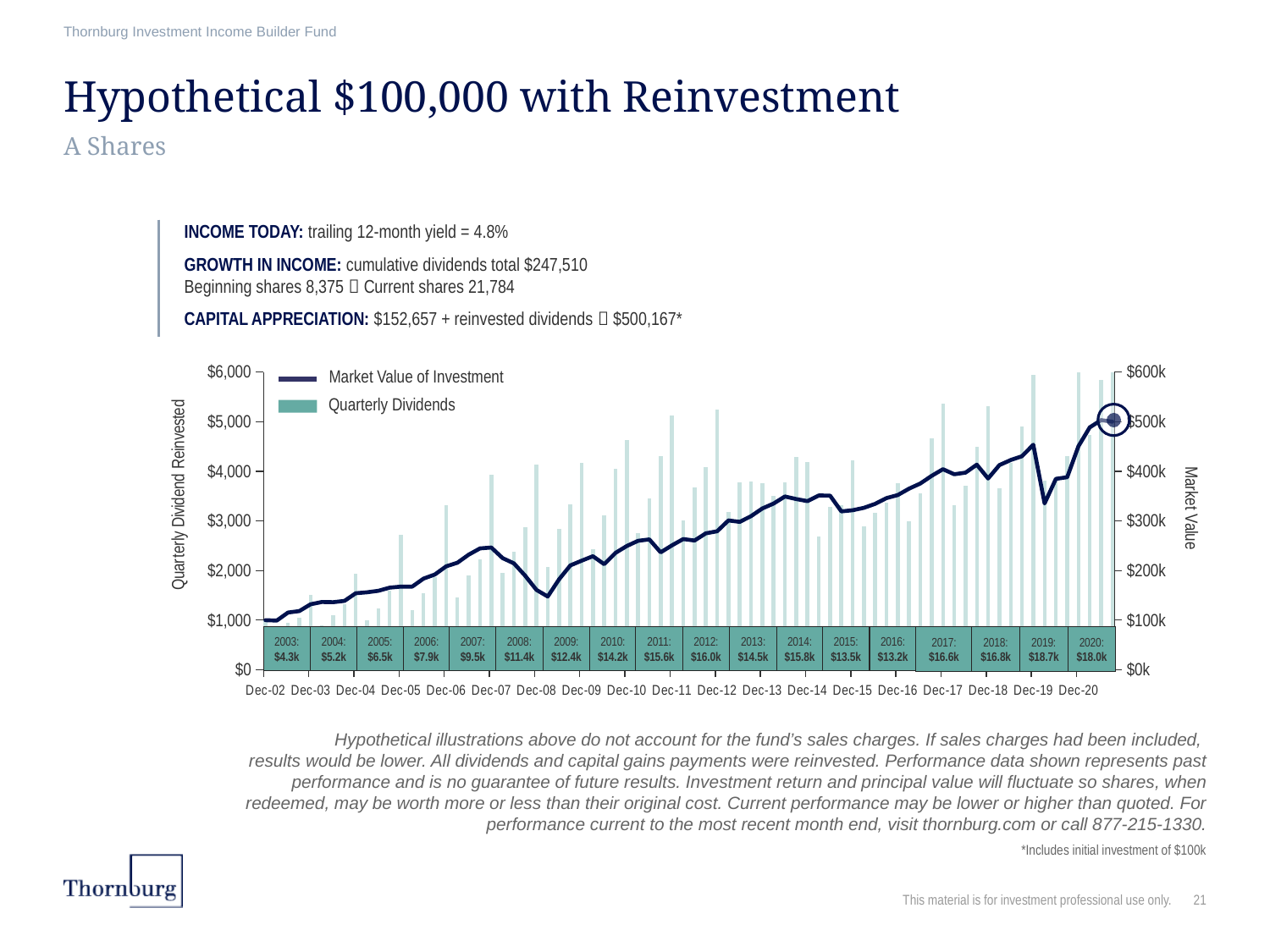
What is the annual dividend total shown for 2019? $18.7k What kind of chart is shown on the slide? Combined bar and line chart How many years have annual dividend totals printed in the band along the bottom of the chart? 18 Is the Market Value of Investment at Dec-20 greater or less than $400k? greater Which year has the lowest annual dividend total shown in the band along the bottom of the chart? 2003 Does the Market Value of Investment line generally rise or fall from Dec-02 to Dec-20? Rise Which year has the highest annual dividend total shown in the band along the bottom of the chart? 2019 What is the difference between the annual dividend totals for 2020 and 2003? $13.7k Which year has the larger annual dividend total, 2013 or 2014? 2014 What is the annual dividend total shown for 2010? $14.2k Is the Market Value of Investment at Dec-08 greater or less than $200k? less How many series does the chart legend list? 2